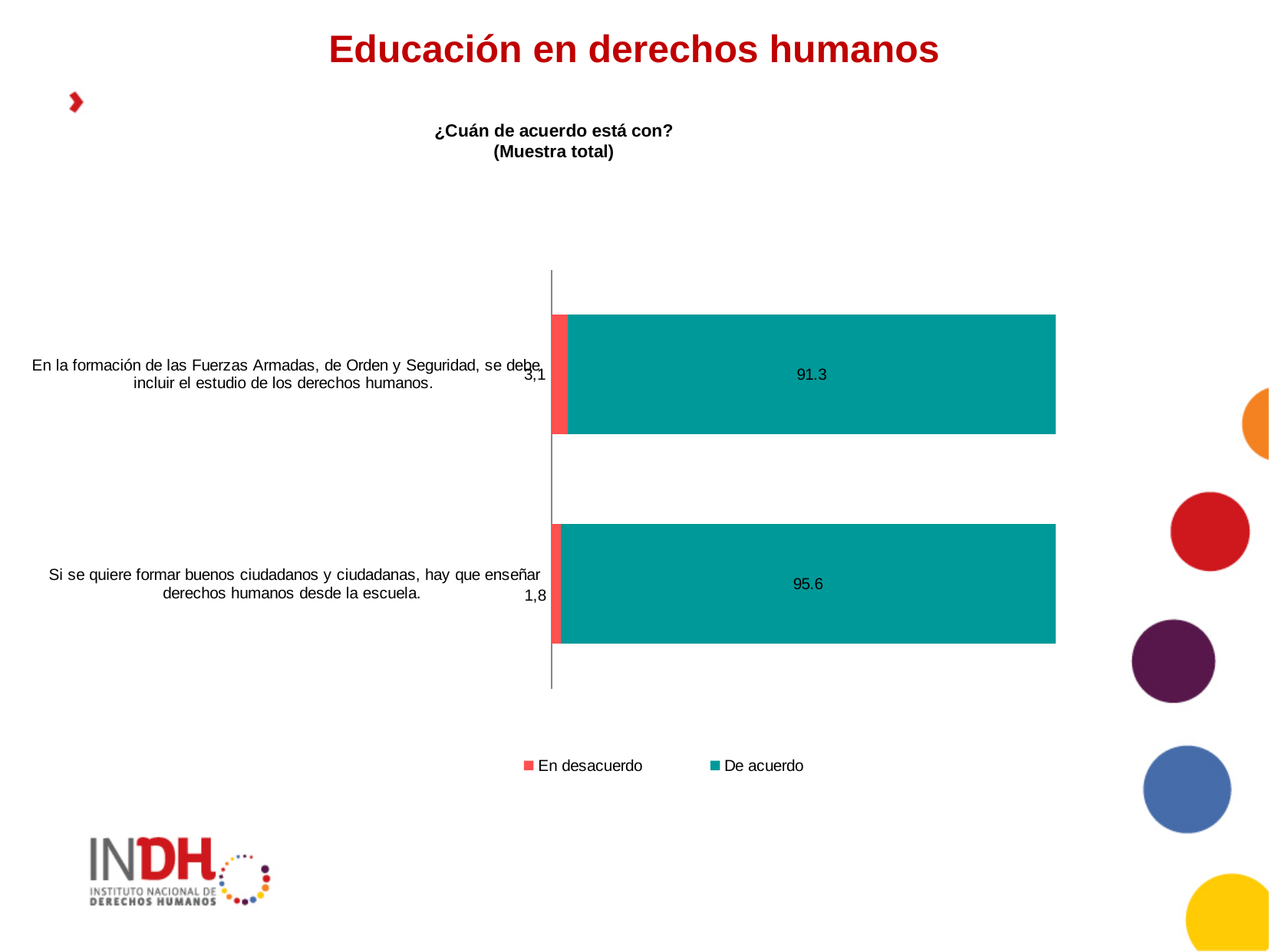
Which statement has the lower 'En desacuerdo' value? Si se quiere formar buenos ciudadanos y ciudadanas, hay que enseñar derechos humanos desde la escuela. Is the 'De acuerdo' value for the Fuerzas Armadas statement larger or smaller than the 'De acuerdo' value for the school statement? smaller What type of chart is shown on the slide? bar chart What is the difference between the 'De acuerdo' values of the two statements? 4.3 What is the 'De acuerdo' value for the statement about including human rights study in the training of the Fuerzas Armadas, de Orden y Seguridad? 91.3 How many series does the legend list? 2 What is the 'En desacuerdo' value for the statement about the Fuerzas Armadas, de Orden y Seguridad? 3,1 How many categories (statements) are plotted in the chart? 2 Which statement has the higher 'De acuerdo' value? Si se quiere formar buenos ciudadanos y ciudadanas, hay que enseñar derechos humanos desde la escuela. What is the title of the chart? ¿Cuán de acuerdo está con? (Muestra total) What is the 'En desacuerdo' value for the statement about teaching human rights from school? 1,8 What is the 'De acuerdo' value for the statement that human rights must be taught from school to form good citizens? 95.6